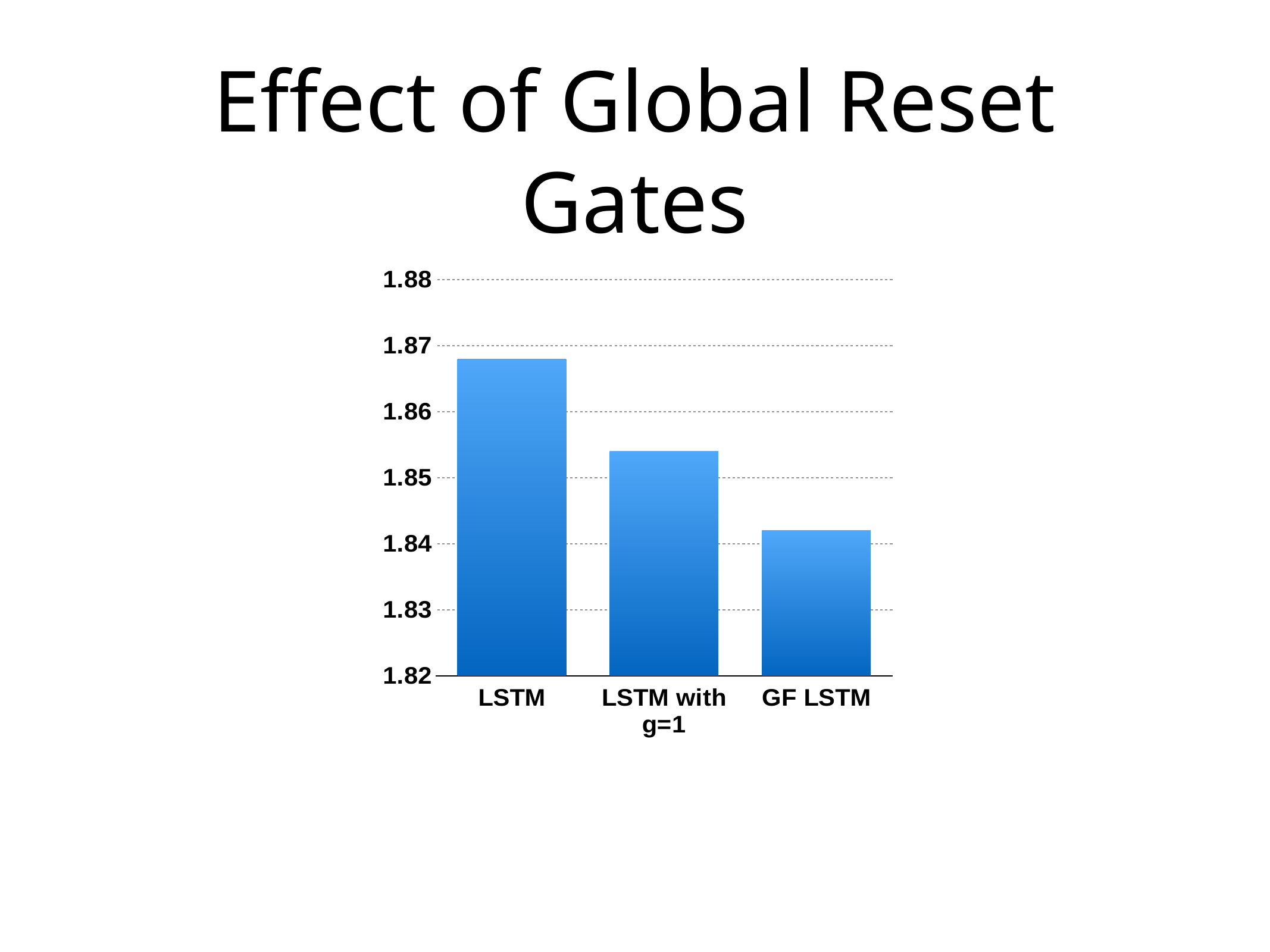
Is the value for LSTM with g=1 greater or less than 1.86? less Which is larger, the value for LSTM or the value for GF LSTM? LSTM Which category has the highest value? LSTM Is the value for LSTM greater or less than 1.86? greater Which category has the lowest value? GF LSTM How many categories are plotted in the chart? 3 Do the values rise or fall moving from left to right across the categories? fall What kind of chart is shown on the slide? bar chart Is the value for LSTM with g=1 greater or less than 1.85? greater Which is larger, the value for LSTM with g=1 or the value for GF LSTM? LSTM with g=1 What is the title of the slide containing the chart? Effect of Global Reset Gates